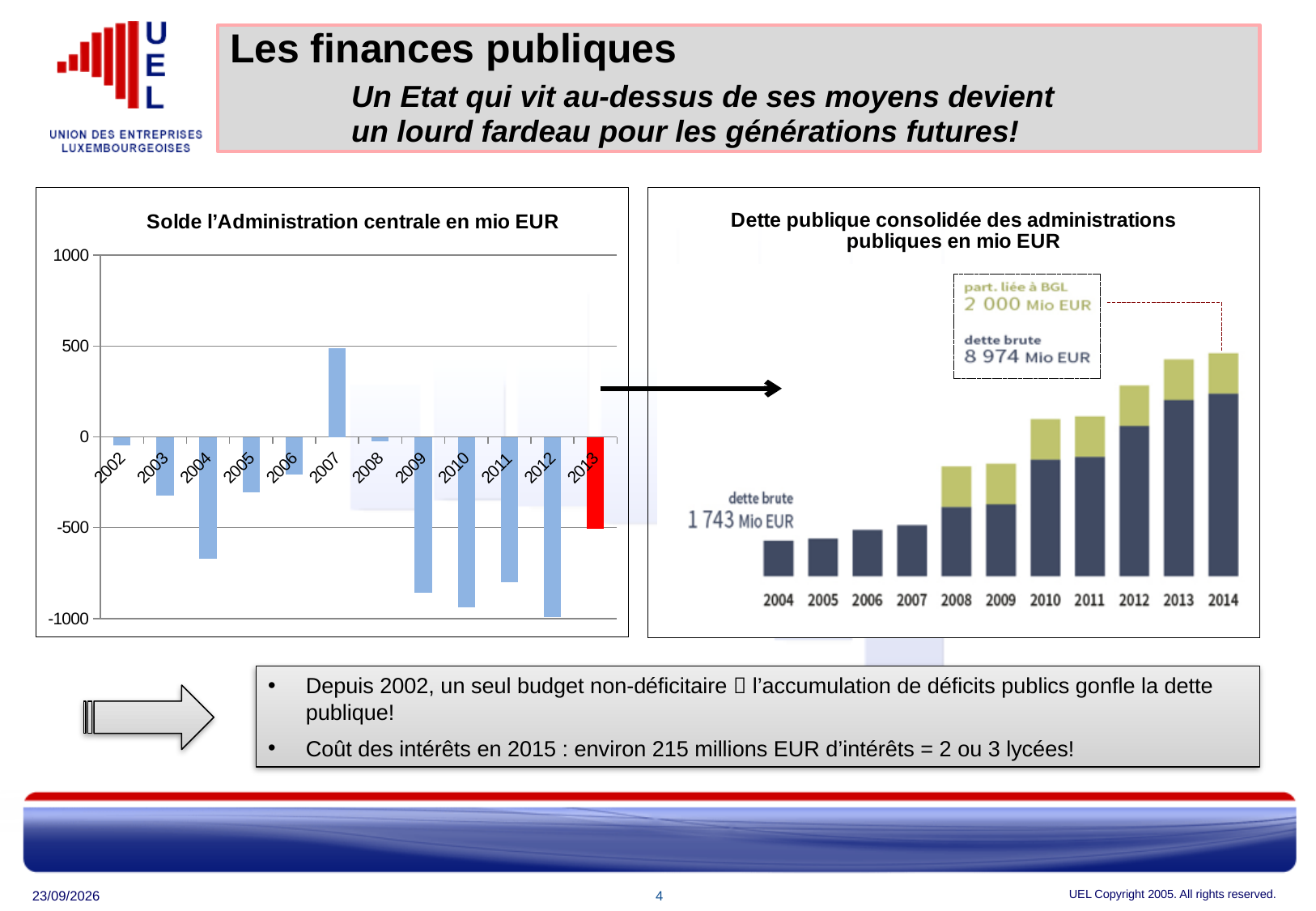
In the left chart, 'Solde l'Administration centrale en mio EUR', which year has the highest value? 2007 In the right chart, 'Dette publique consolidée des administrations publiques en mio EUR', what is the dette brute for 2004? 1 743 Mio EUR In the left chart, 'Solde l'Administration centrale en mio EUR', is the value for 2003 greater or less than -500? greater In the left chart, 'Solde l'Administration centrale en mio EUR', is the value for 2009 greater or less than -500? less In the left chart, 'Solde l'Administration centrale en mio EUR', what colour is the bar for 2013? Red How many years are shown on the x axis of the left chart, 'Solde l'Administration centrale en mio EUR'? 12 In the right chart, 'Dette publique consolidée des administrations publiques en mio EUR', what is the dette brute for 2014? 8 974 Mio EUR In the left chart, 'Solde l'Administration centrale en mio EUR', which year has the larger value, 2003 or 2010? 2003 In the right chart, 'Dette publique consolidée des administrations publiques en mio EUR', what is the difference between the dette brute in 2014 and in 2004? 7 231 Mio EUR In the right chart, 'Dette publique consolidée des administrations publiques en mio EUR', do the values rise or fall from 2004 to 2014? Rise In the left chart, 'Solde l'Administration centrale en mio EUR', which year has the lowest value? 2012 What kind of chart is the left chart, 'Solde l'Administration centrale en mio EUR'? Bar chart